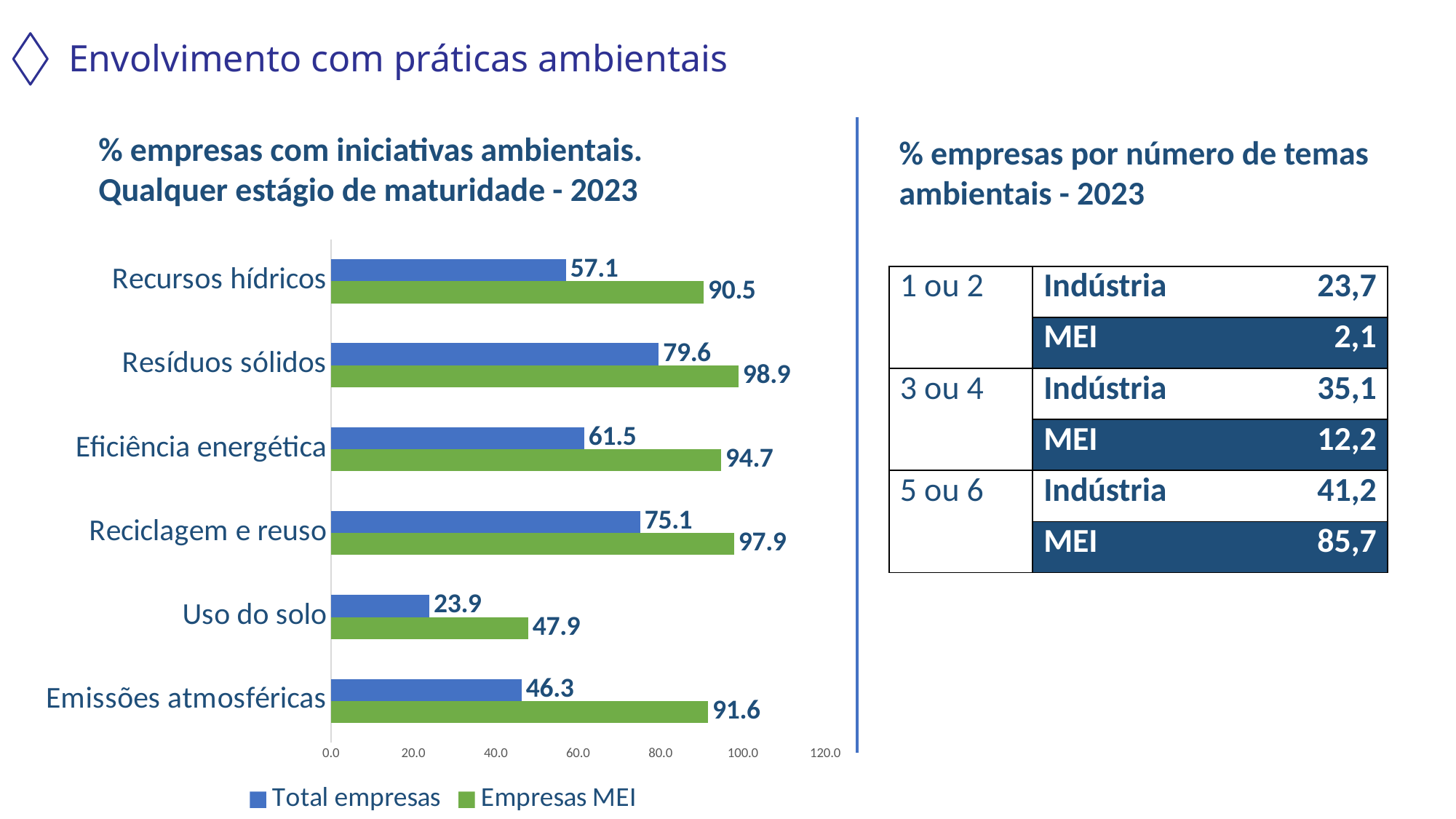
Which is larger for Total empresas: Eficiência energética or Reciclagem e reuso? Reciclagem e reuso Is the Total empresas value for Emissões atmosféricas greater or less than 60.0? less What is the difference between the Empresas MEI and Total empresas values for Recursos hídricos? 33.4 What is the difference between the Empresas MEI and Total empresas values for Uso do solo? 24.0 What is the value for Empresas MEI for Emissões atmosféricas? 91.6 How many categories are shown in the chart? 6 Which category has the highest value for Total empresas? Resíduos sólidos What kind of chart is shown on the slide? bar chart What is the value for Total empresas for Recursos hídricos? 57.1 Which category has the lowest value for Empresas MEI? Uso do solo How many series does the chart legend list? 2 What is the value for Empresas MEI for Reciclagem e reuso? 97.9